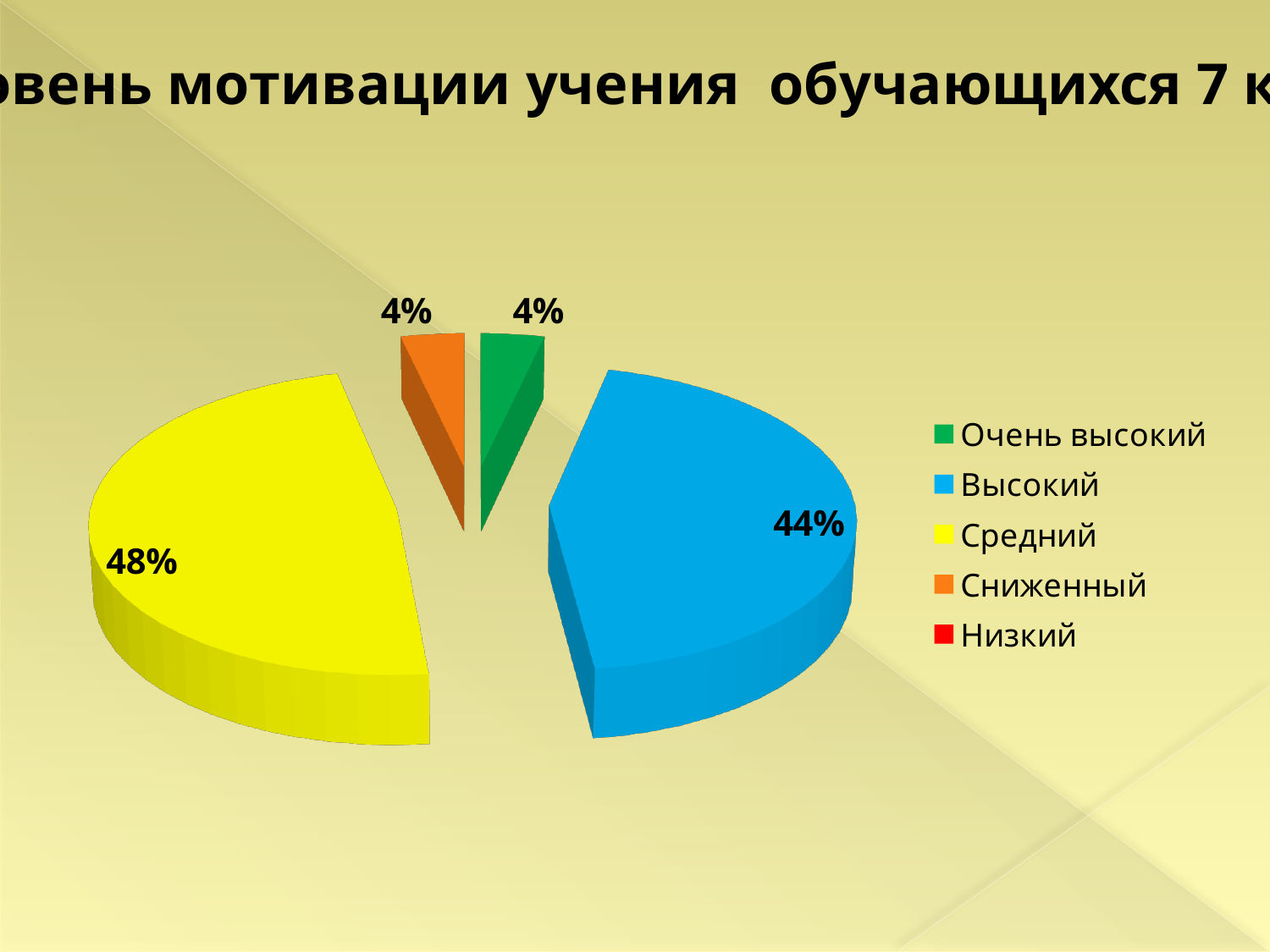
What percentage of the pie does the Средний slice represent? 48% What colour is used for the Высокий category? Blue What is the value shown for the Высокий slice? 44% Which is larger, the Средний slice or the Высокий slice? Средний What colour is used for the Средний category? Yellow What is the difference in percentage points between the Средний and Высокий slices? 4% What type of chart is shown on the slide? Pie chart How many categories are listed in the legend? 5 What percentage is shown for Очень высокий? 4% Which category has the largest slice of the pie? Средний What percentage is shown for Сниженный? 4% What is the combined share of the Высокий and Средний slices? 92%